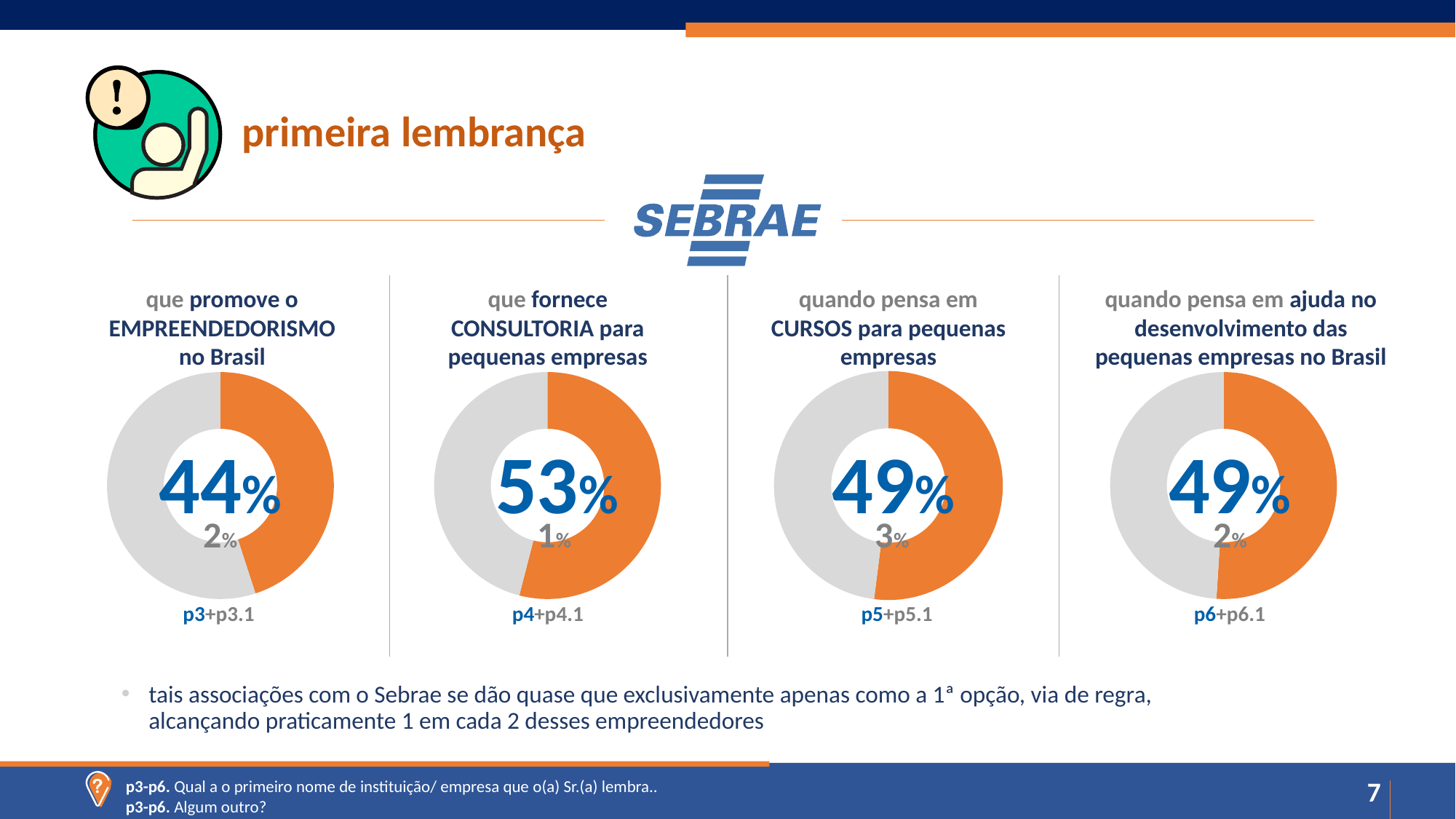
In the chart 'quando pensa em CURSOS para pequenas empresas', what is the smaller grey percentage shown below the main value? 3% In the chart 'que fornece CONSULTORIA para pequenas empresas', what is the large percentage shown in the centre of the donut? 53% In the chart 'que fornece CONSULTORIA para pequenas empresas', what is the smaller grey percentage shown below the main value? 1% In the chart 'que promove o EMPREENDEDORISMO no Brasil', what is the large percentage shown in the centre of the donut? 44% How many donut charts are shown on the slide? 4 What type of chart is used to display the percentages on this slide? Donut (pie) chart Which is larger: the main percentage in the CONSULTORIA chart or the main percentage in the CURSOS chart? CONSULTORIA (53%) What is the difference between the main percentage in the CONSULTORIA chart and the main percentage in the EMPREENDEDORISMO chart? 9 percentage points In the chart 'quando pensa em CURSOS para pequenas empresas', what is the large percentage shown in the centre of the donut? 49% Which of the four donut charts shows the highest main percentage? que fornece CONSULTORIA para pequenas empresas (53%) In the chart 'quando pensa em ajuda no desenvolvimento das pequenas empresas no Brasil', what is the smaller grey percentage shown below the main value? 2% Which of the four donut charts shows the lowest main percentage? que promove o EMPREENDEDORISMO no Brasil (44%)